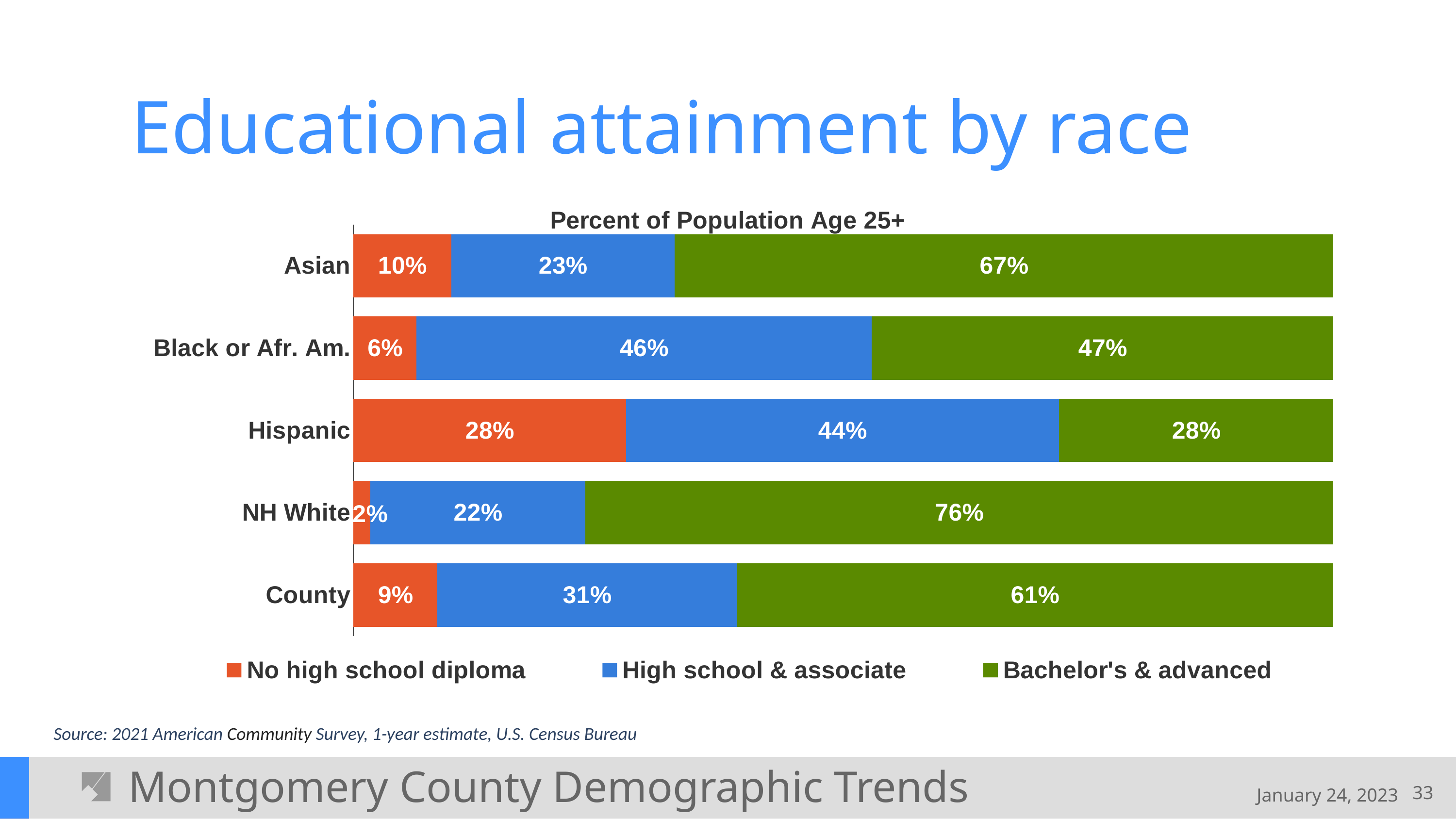
What is the High school & associate value for Black or Afr. Am.? 46% How many categories are shown on the chart? 5 Which category has the lowest No high school diploma percentage? NH White How many series does the legend list? 3 What is the Bachelor's & advanced value for County? 61% What kind of chart is shown on the slide? Stacked bar chart Which is larger: the High school & associate value for County or for Asian? County What percentage of the Asian population age 25+ has a Bachelor's & advanced degree? 67% What is the difference between the Bachelor's & advanced values for NH White and Hispanic? 48% What is the value for No high school diploma for Hispanic? 28% Which category has the highest Bachelor's & advanced percentage? NH White What is the title shown above the chart? Percent of Population Age 25+